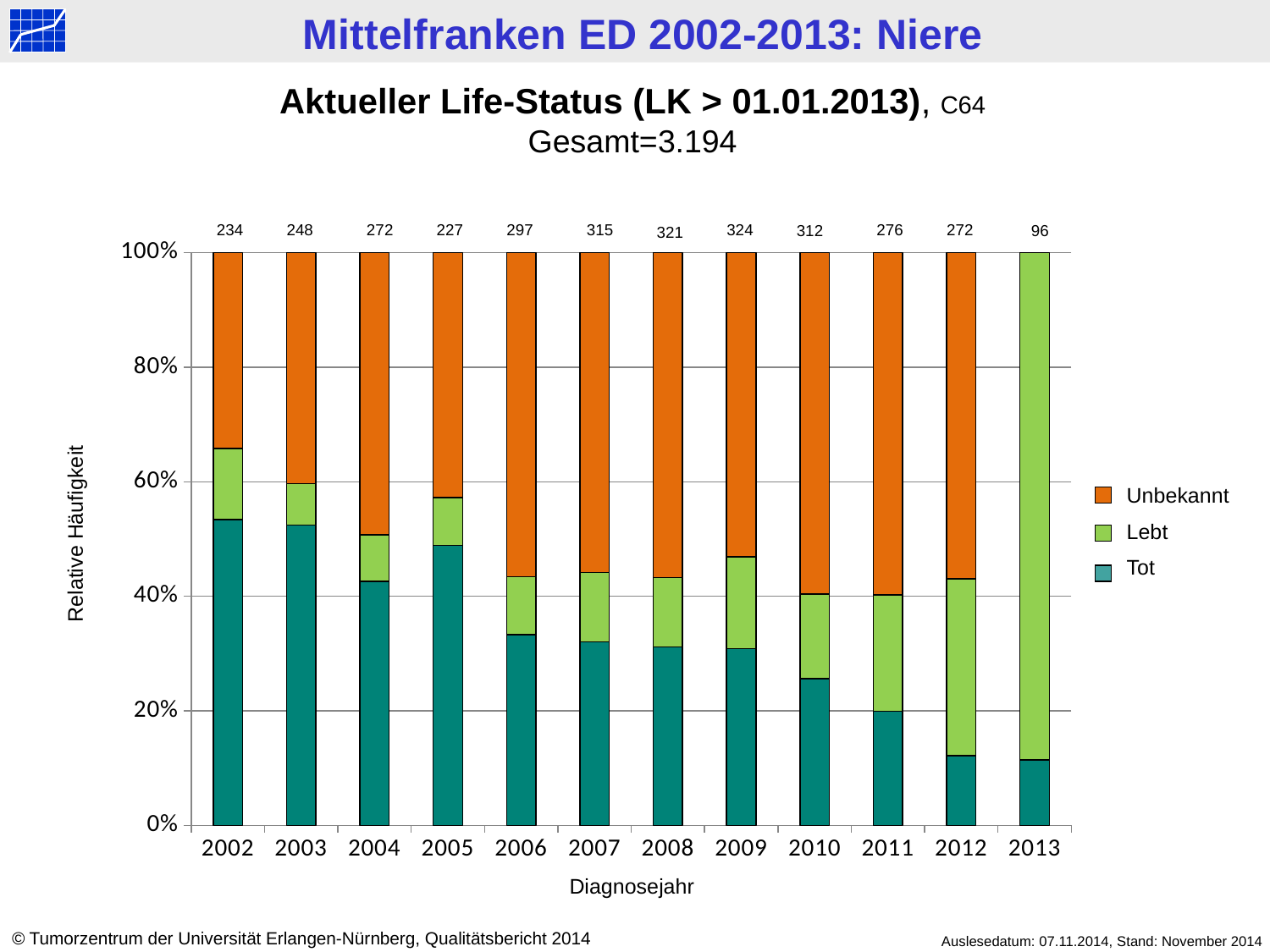
How many series does the legend list? 3 What is the number printed above the bar for 2005? 227 What kind of chart is shown on the slide? Stacked bar chart Which year has the larger number printed above its bar, 2006 or 2007? 2007 Is the share of 'Tot' in 2013 greater or less than 20%? less What is the number printed above the bar for 2009? 324 What is the number printed above the bar for 2013? 96 Is the share of 'Tot' in 2002 greater or less than 40%? greater Which diagnosis year has the lowest number printed above its bar? 2013 How many diagnosis years are shown on the x axis? 12 What is the difference between the numbers printed above the bars for 2009 and 2013? 228 Which diagnosis year has the highest number printed above its bar? 2009